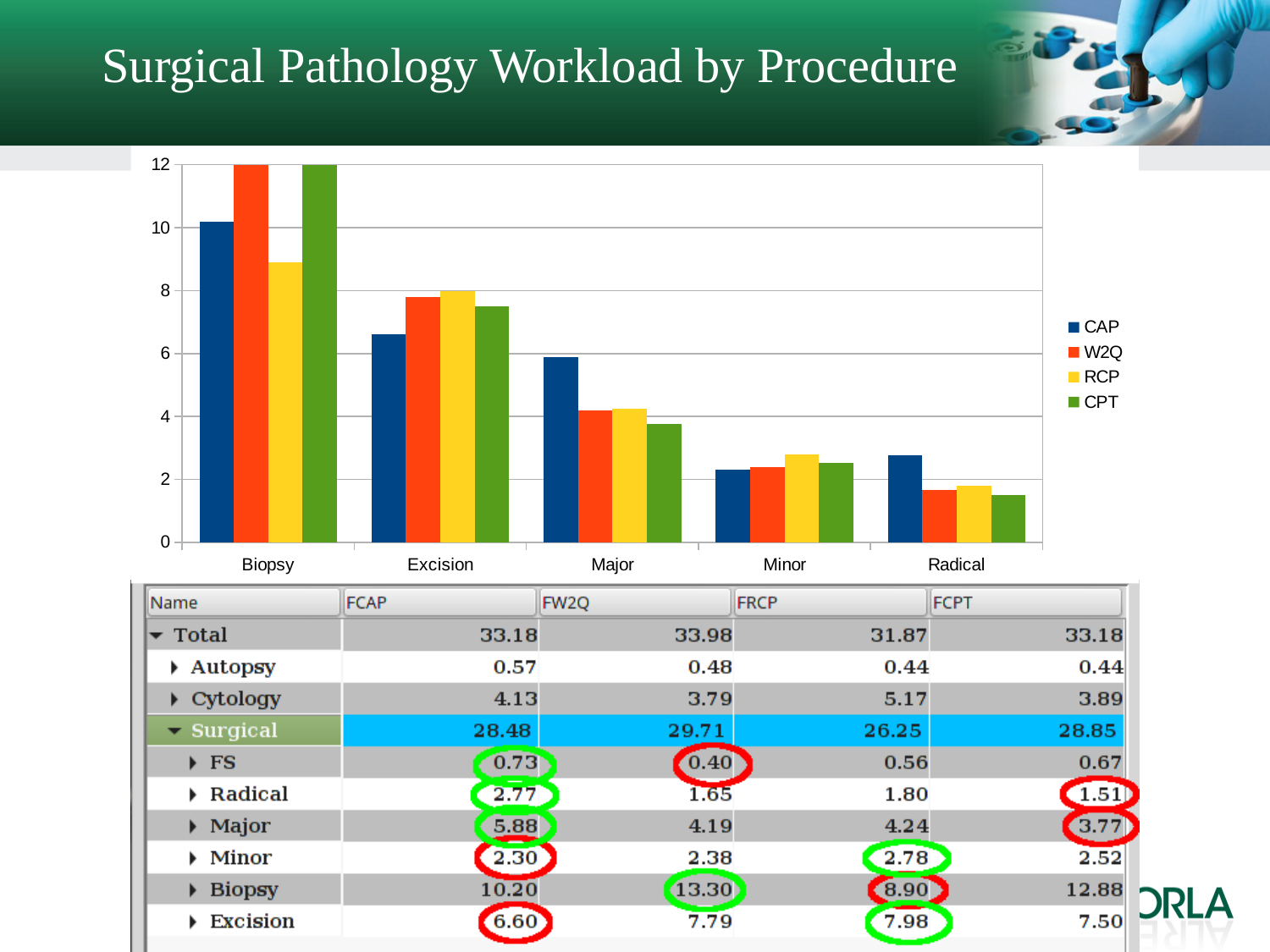
According to the table, what is the FCAP value for Biopsy? 10.20 For Excision, which is larger, the CAP bar or the RCP bar? RCP In the chart, is the CPT value for Radical greater or less than 2? less Which category has the lowest CAP bar in the chart? Minor Do the CAP bars rise or fall from Biopsy to Minor along the x axis? fall How many series does the chart's legend list? 4 Using the table, what is the difference between the FW2Q and FCAP values for Biopsy? 3.10 Which category has the highest RCP bar in the chart? Biopsy What kind of chart is shown on the slide? bar chart In the chart, is the CAP value for Major greater or less than 4? greater How many procedure categories are shown on the x axis of the chart? 5 According to the table, what is the FRCP value for the Surgical row? 26.25